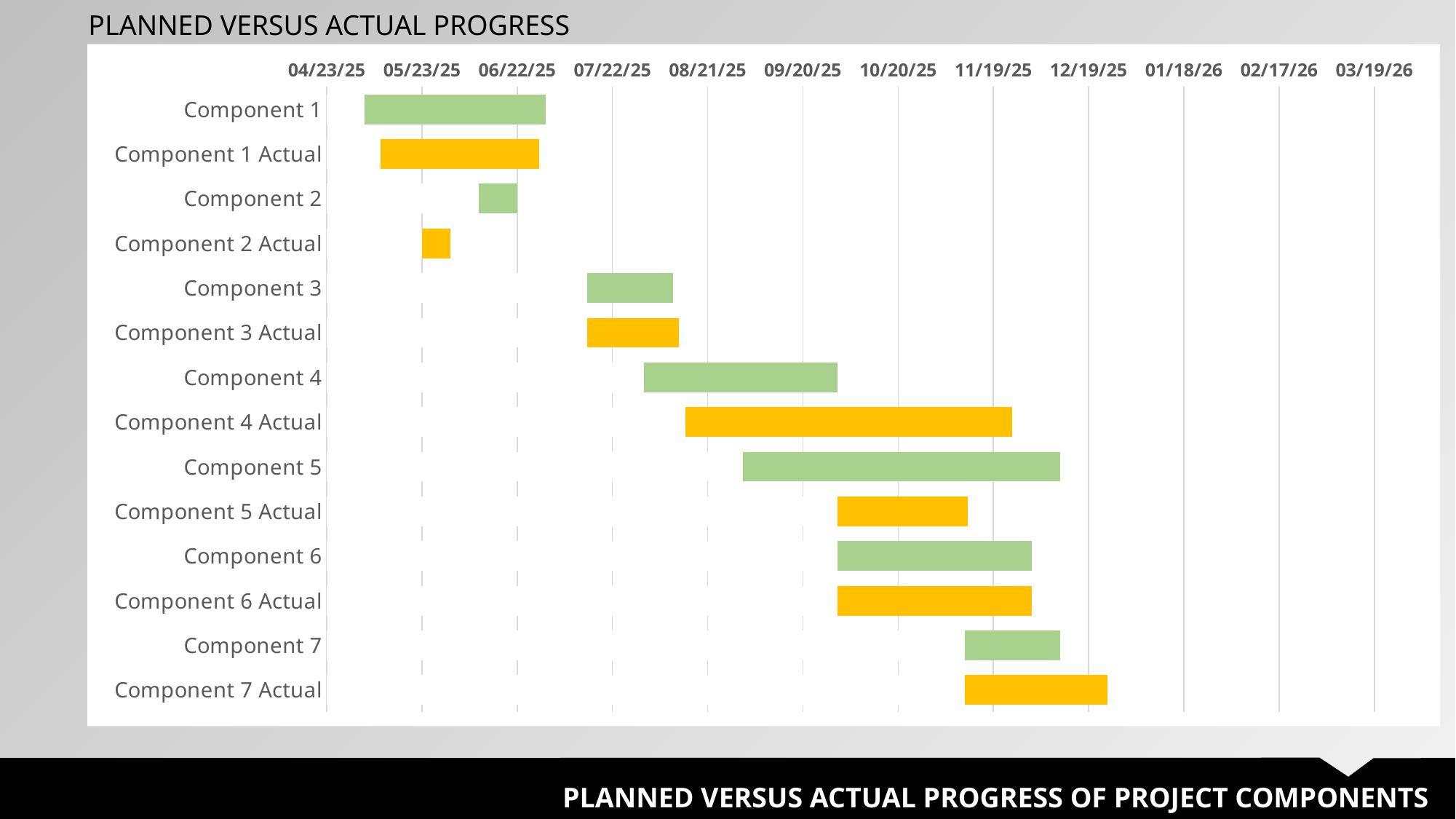
What is the title of the chart? PLANNED VERSUS ACTUAL PROGRESS What colour are the 'Actual' bars in the chart? Yellow/orange Which row's bar starts earliest on the timeline? Component 1 Which row's bar ends latest on the timeline? Component 7 Actual Which bar is longer, Component 7 or Component 7 Actual? Component 7 Actual Does the Component 1 bar start before or after 05/23/25? before How many rows (categories) are listed on the vertical axis of the chart? 14 Which row has the shortest bar in the chart? Component 2 Actual Which bar is longer, Component 5 or Component 5 Actual? Component 5 Which bar is longer, Component 2 or Component 2 Actual? Component 2 What kind of chart is shown on the slide? Bar chart (Gantt chart) Does the Component 7 Actual bar end before or after 12/19/25? after